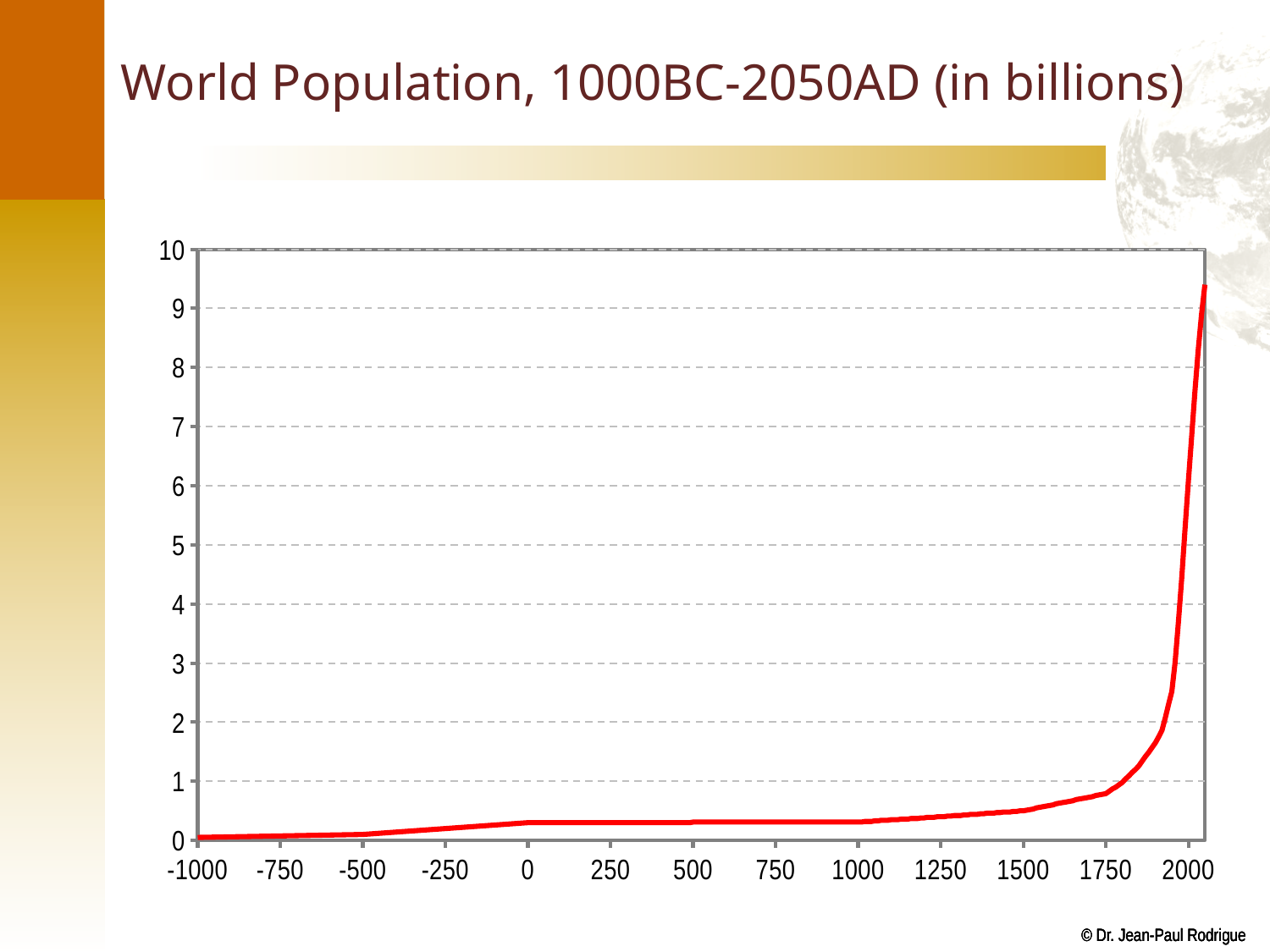
How many labelled tick marks are there on the x axis? 13 What is the maximum value shown on the y axis? 10 At which end of the x axis does the line reach its highest value? the right end (around 2050) Is the value for the year 0 greater or less than 1? less What is the title of the chart? World Population, 1000BC-2050AD (in billions) Is the value at the right end of the line (around 2050) greater or less than 8? greater Is the value for the year 1000 greater or less than 1? less What kind of chart is shown on the slide? line chart At which x-axis value is the plotted population lowest? -1000 Does the world population line rise or fall overall from left to right along the x axis? rise